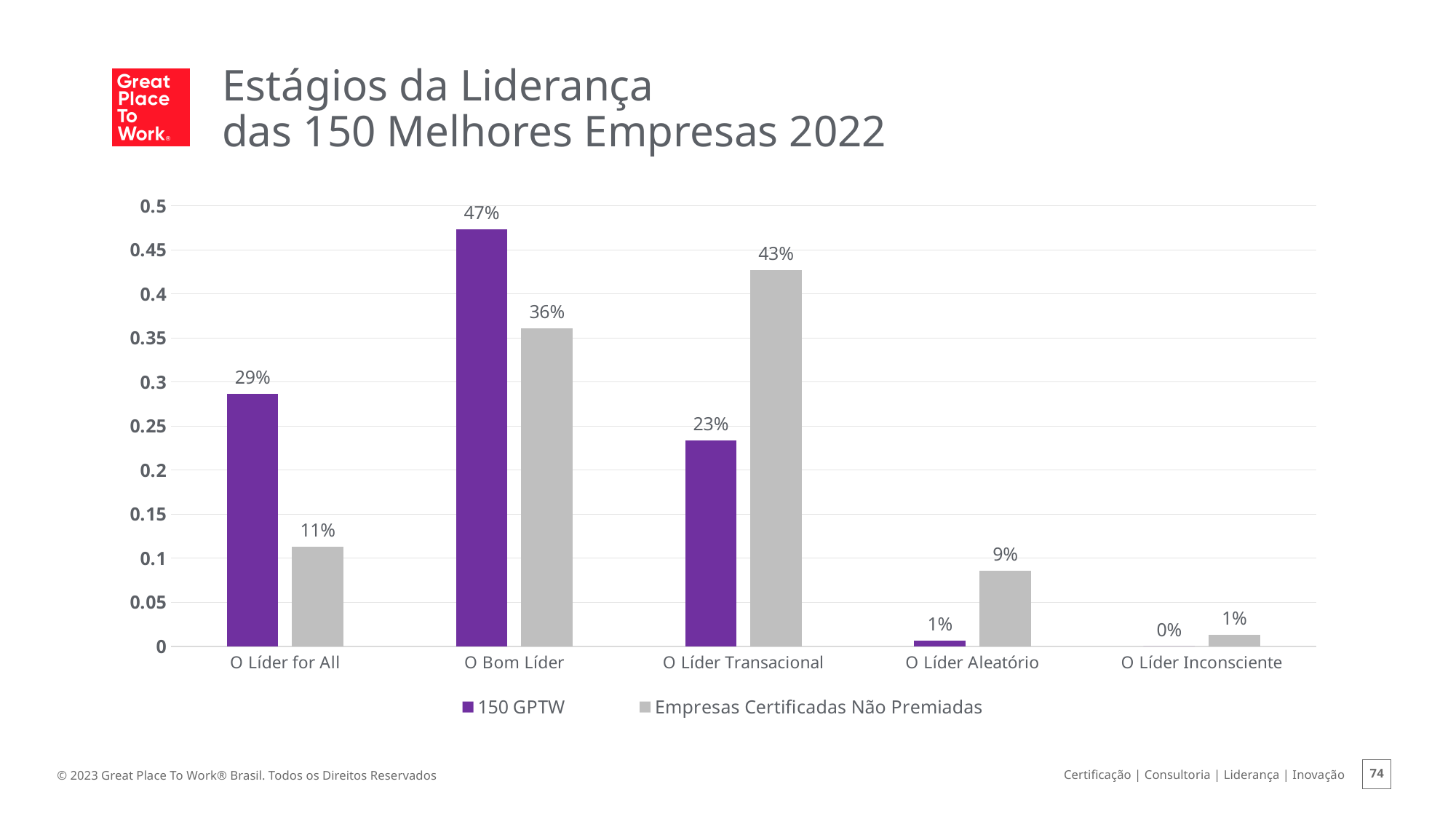
Which series has the larger value for O Líder Transacional, 150 GPTW or Empresas Certificadas Não Premiadas? Empresas Certificadas Não Premiadas What is the value for Empresas Certificadas Não Premiadas in the O Líder for All category? 11% Which category has the lowest value for the 150 GPTW series? O Líder Inconsciente How many series does the legend list? 2 What is the difference between the 150 GPTW and Empresas Certificadas Não Premiadas values for O Líder for All? 18% How many categories are shown on the x axis? 5 What is the difference between the 150 GPTW and Empresas Certificadas Não Premiadas values for O Bom Líder? 11% Which category has the highest value for the 150 GPTW series? O Bom Líder What colour are the bars for the 150 GPTW series? Purple What is the value for 150 GPTW in the O Bom Líder category? 47% What kind of chart is shown on the slide? Bar chart What is the value for Empresas Certificadas Não Premiadas in the O Líder Transacional category? 43%